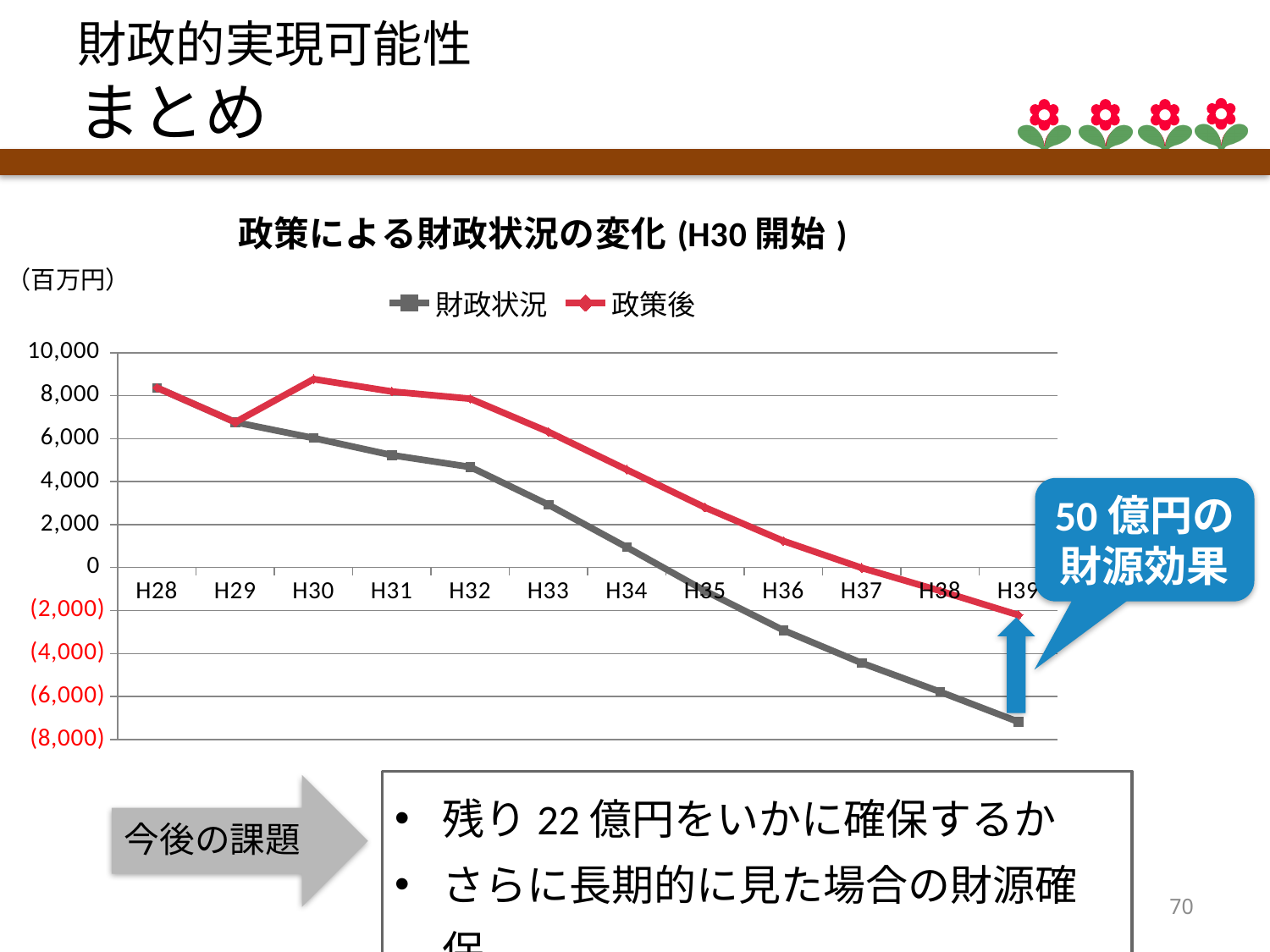
In which year does the 政策後 series reach its highest value? H30 Is the value for 財政状況 at H34 greater or less than 2,000? less What is the title of the chart? 政策による財政状況の変化 (H30 開始 ) How many points are plotted along the x axis for each series? 12 How many series does the legend list? 2 Which series is drawn in red? 政策後 In which year does the 財政状況 series reach its lowest value? H39 Does the 財政状況 series rise or fall from H28 to H39? fall At H30, which series has the larger value, 財政状況 or 政策後? 政策後 Is the value for 政策後 at H30 greater or less than 8,000? greater What kind of chart is shown on the slide? line chart Is the value for 政策後 at H34 greater or less than 4,000? greater